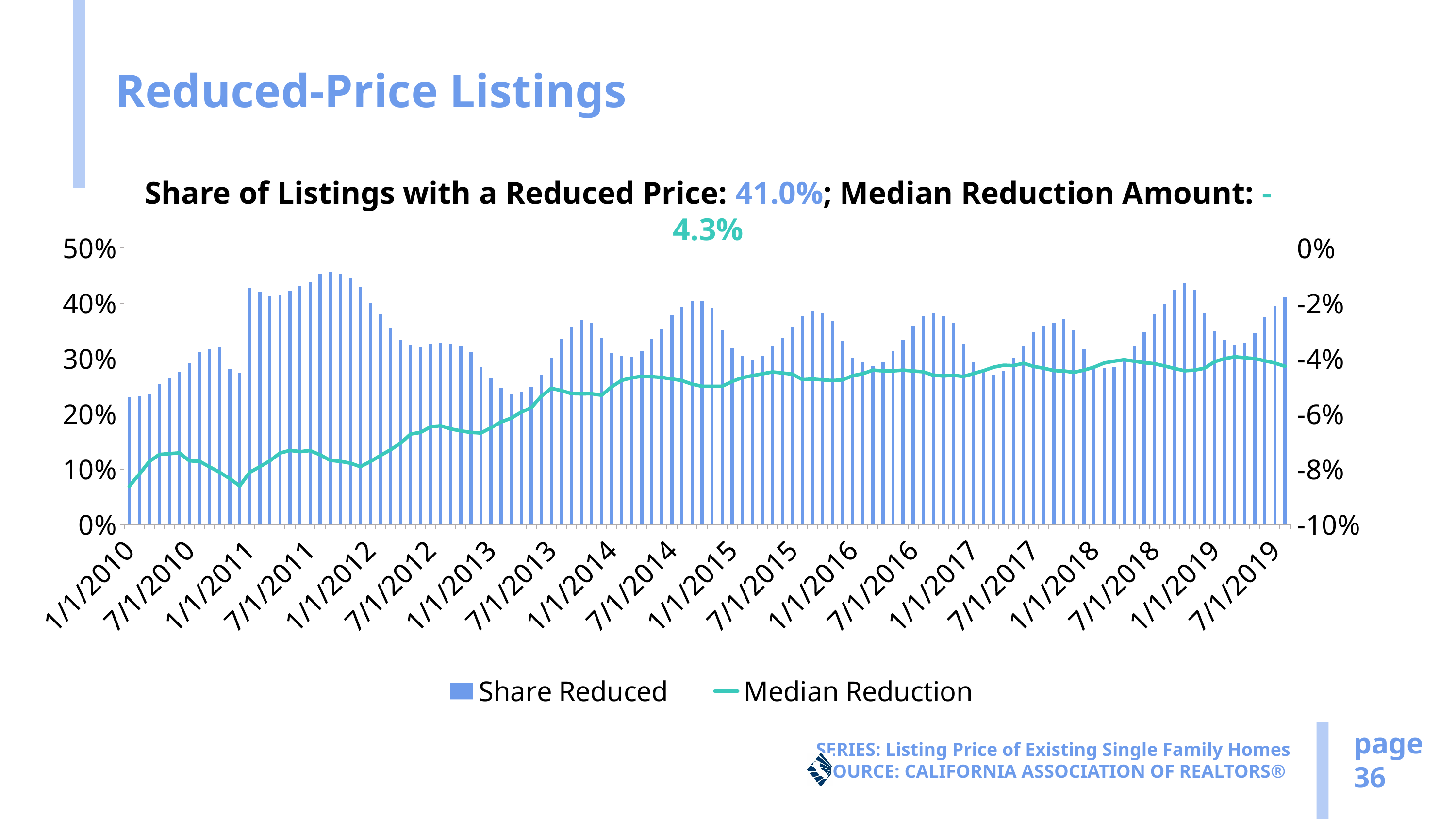
According to the chart title, what is the latest Share of Listings with a Reduced Price? 41.0% Which has the larger Share Reduced value, 1/1/2013 or 7/1/2013? 7/1/2013 Does the Median Reduction line generally rise or fall from 1/1/2010 to 7/1/2019? rise Which has the larger Share Reduced value, 1/1/2010 or 1/1/2012? 1/1/2012 How many date labels are shown along the x axis? 20 Is the Share Reduced value for 1/1/2010 greater or less than 30%? less Is the Median Reduction value for 1/1/2016 greater or less than -6%? greater How many series does the legend list? 2 What kind of chart is shown on the slide? A combined bar and line chart According to the chart title, what is the latest Median Reduction Amount? -4.3% What are the two series named in the legend? Share Reduced and Median Reduction